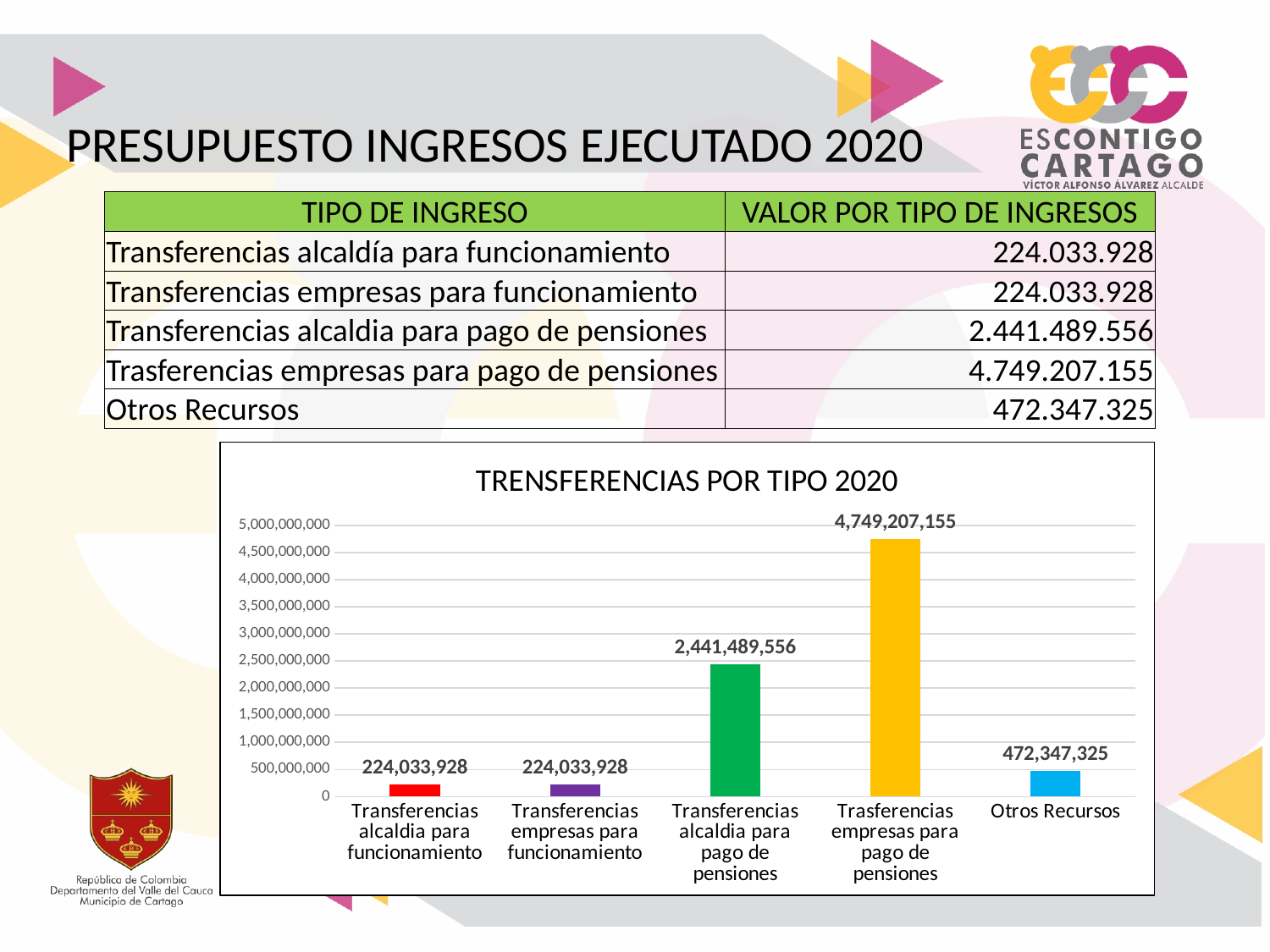
What is the value for Otros Recursos? 472,347,325 What is the title of the chart? TRENSFERENCIAS POR TIPO 2020 Is the value for Otros Recursos greater or less than 500,000,000? less Which is larger, Otros Recursos or Transferencias alcaldia para funcionamiento? Otros Recursos How many categories are plotted in the chart? 5 Which category has the highest value? Trasferencias empresas para pago de pensiones What is the difference between Otros Recursos and Transferencias empresas para funcionamiento? 248,313,397 What is the difference between Trasferencias empresas para pago de pensiones and Transferencias alcaldia para pago de pensiones? 2,307,717,599 What is the value for Trasferencias empresas para pago de pensiones? 4,749,207,155 What type of chart is shown on the slide? Bar chart What is the value for Transferencias alcaldia para pago de pensiones? 2,441,489,556 What is the value for Transferencias alcaldia para funcionamiento? 224,033,928